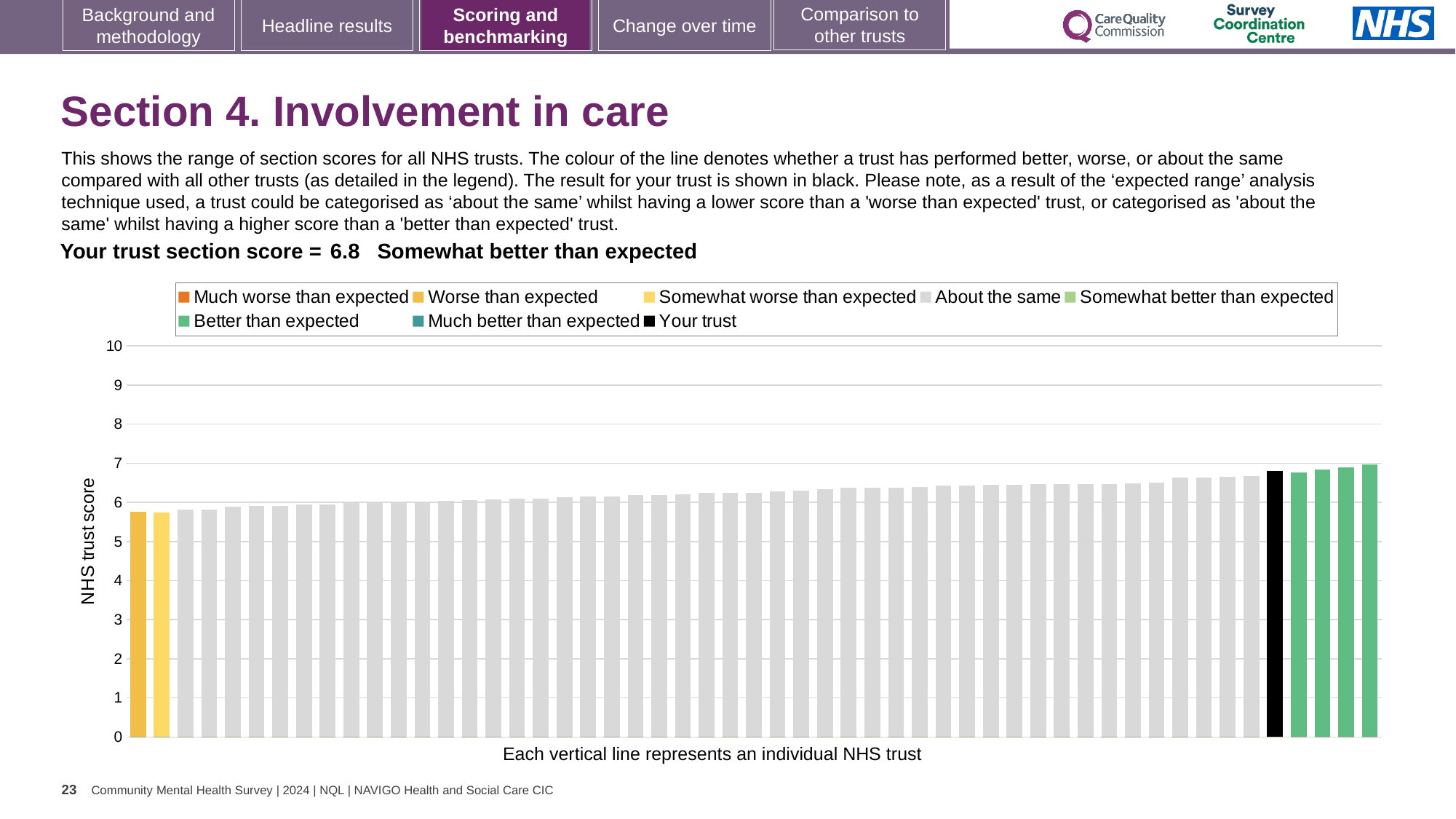
What is the label on the vertical axis of the chart? NHS trust score What is the section score for your trust shown on the slide? 6.8 What kind of chart is shown on the slide? bar chart How many green bars are shown to the right of the black 'Your trust' bar? 4 What is the highest value shown on the vertical axis? 10 How many entries does the chart legend list? 8 Is the value of the black 'Your trust' bar greater or less than 6? greater What colour is used for the 'Your trust' bar according to the legend? black Do the bar values rise or fall from left to right along the x axis? rise Which is higher, the black 'Your trust' bar or the leftmost bar? the black 'Your trust' bar Is the value of the leftmost bar in the chart greater or less than 6? less How many yellow bars are shown at the left end of the chart? 2